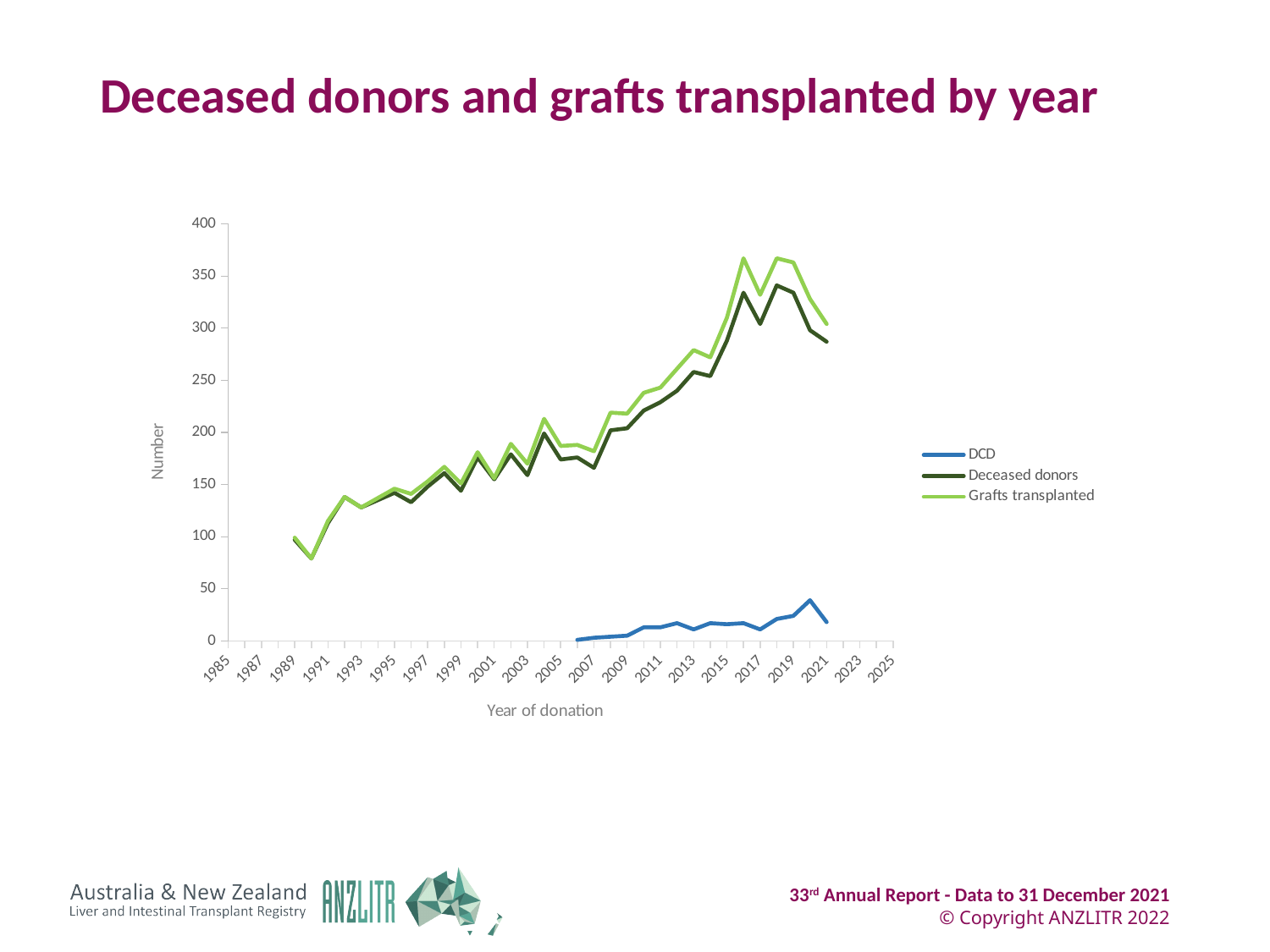
How many series does the legend list? 3 Does the DCD series generally rise or fall from 2007 to 2020? Rise Is the value for Grafts transplanted in 2016 greater or less than 350? greater Is the value for DCD in 2020 greater or less than 50? less What is the title of the x axis? Year of donation Is the value for Deceased donors in 2005 greater or less than 200? less Which series has the lowest values across the chart? DCD What are the three series listed in the legend? DCD, Deceased donors, Grafts transplanted In 2016, which is larger: Grafts transplanted or Deceased donors? Grafts transplanted What kind of chart is shown on the slide? Line chart